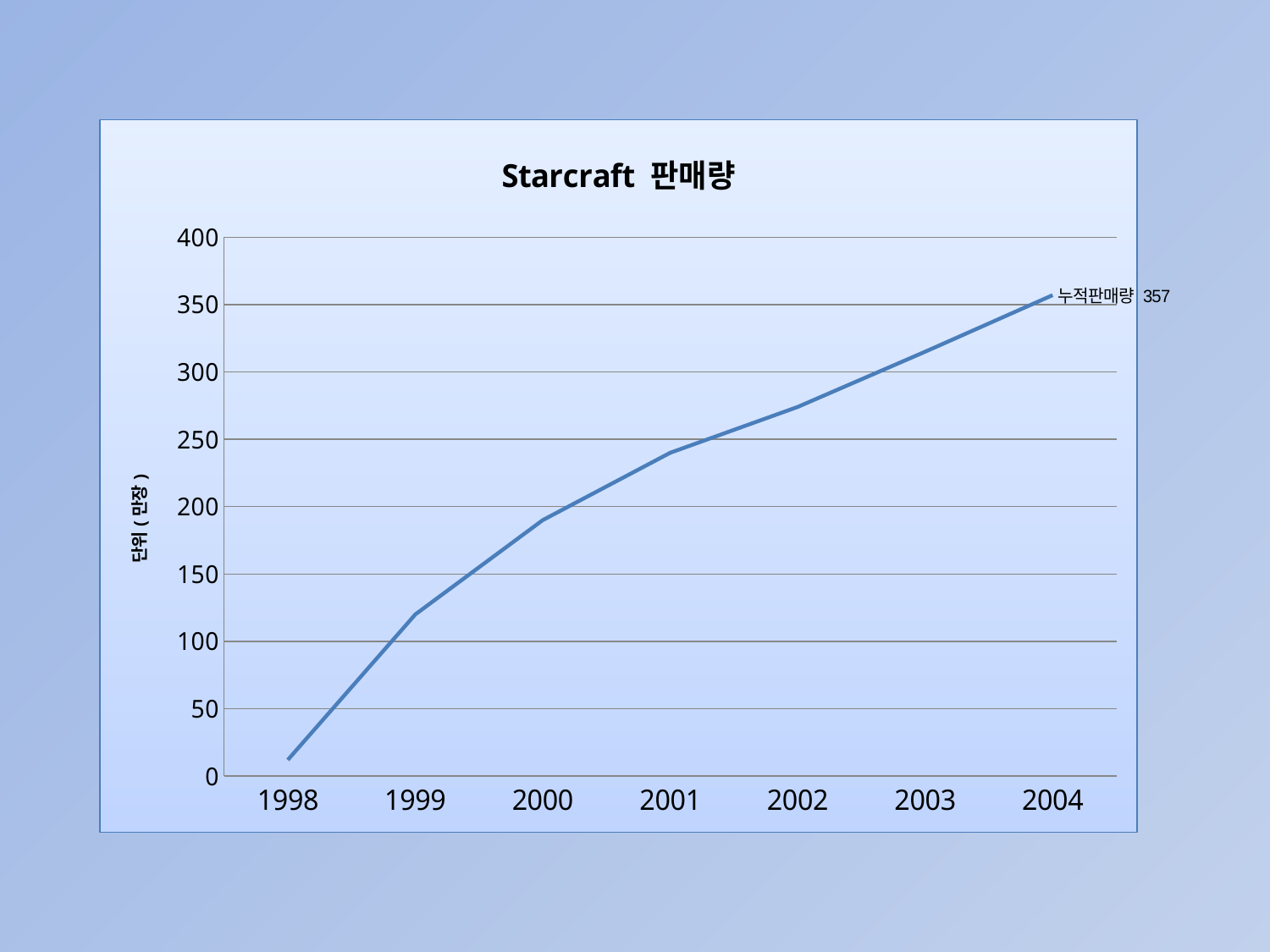
Which year has the lowest value on the line? 1998 What unit label is shown on the y axis? 단위 ( 만장 ) What is the cumulative sales value (누적판매량) labelled at 2004? 357 How many years are plotted along the x axis? 7 What is the title of the chart? Starcraft 판매량 Is the value for 2000 greater or less than 200? less Do the values rise or fall from 1998 to 2004? Rise Which year has the highest value on the line? 2004 Is the value for 1999 greater or less than 100? greater Is the value for 2003 greater or less than 300? greater Which is larger, the value for 2002 or the value for 2000? 2002 What kind of chart is shown on the slide? Line chart